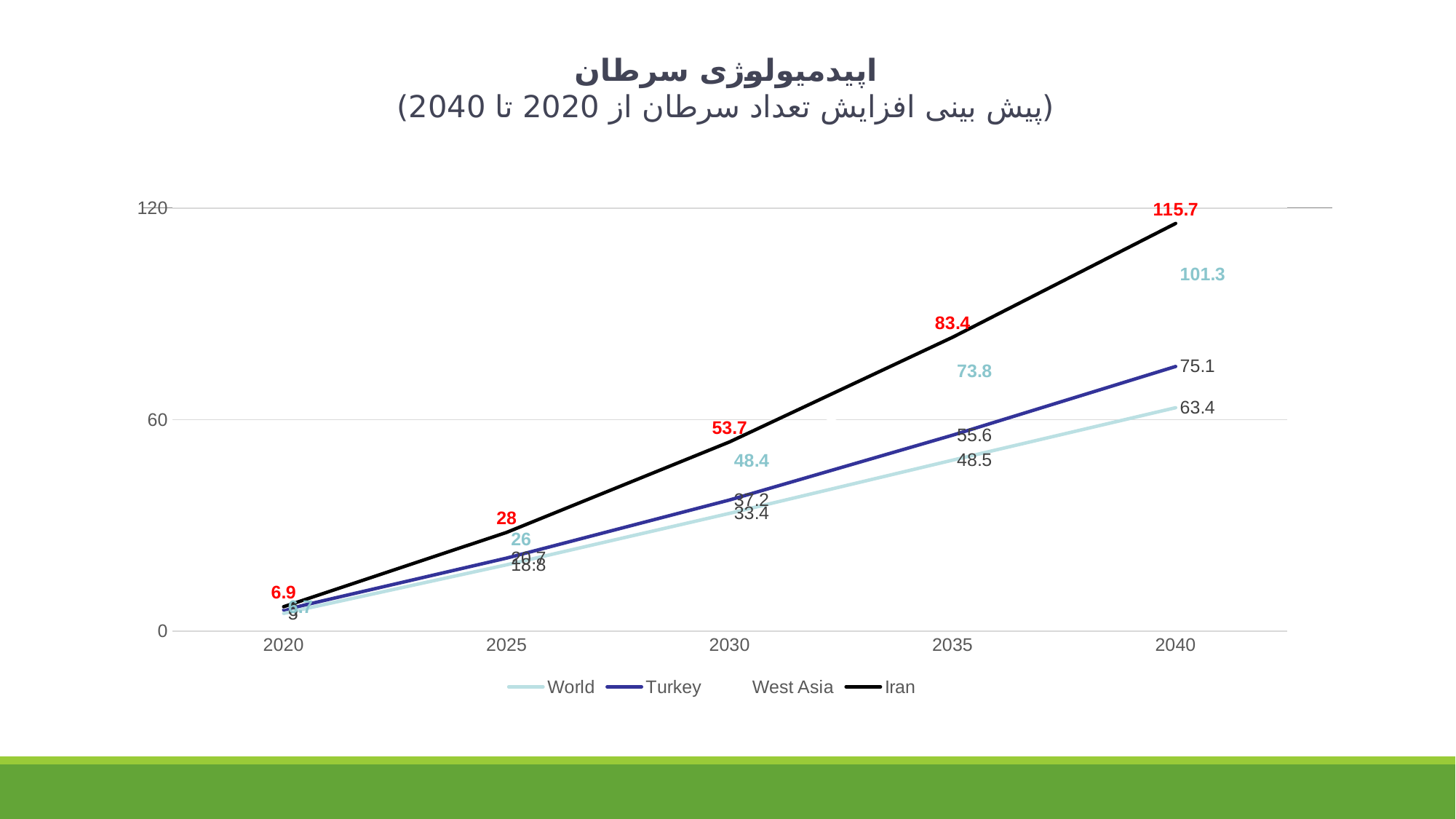
Which is larger in 2035, the value for Iran or the value for West Asia? Iran Which series has the highest value in 2040? Iran How many years are marked along the x axis? 5 What kind of chart is shown on the slide? line chart What is the value for World in 2030? 33.4 What is the value for Turkey in 2035? 55.6 What is the value for West Asia in 2030? 48.4 How many series does the legend list? 4 What is the value for Iran in 2040? 115.7 Do the values for Iran rise or fall from 2020 to 2040? rise What is the difference between the Iran and Turkey values in 2040? 40.6 Is the value for World in 2040 greater or less than 60? greater